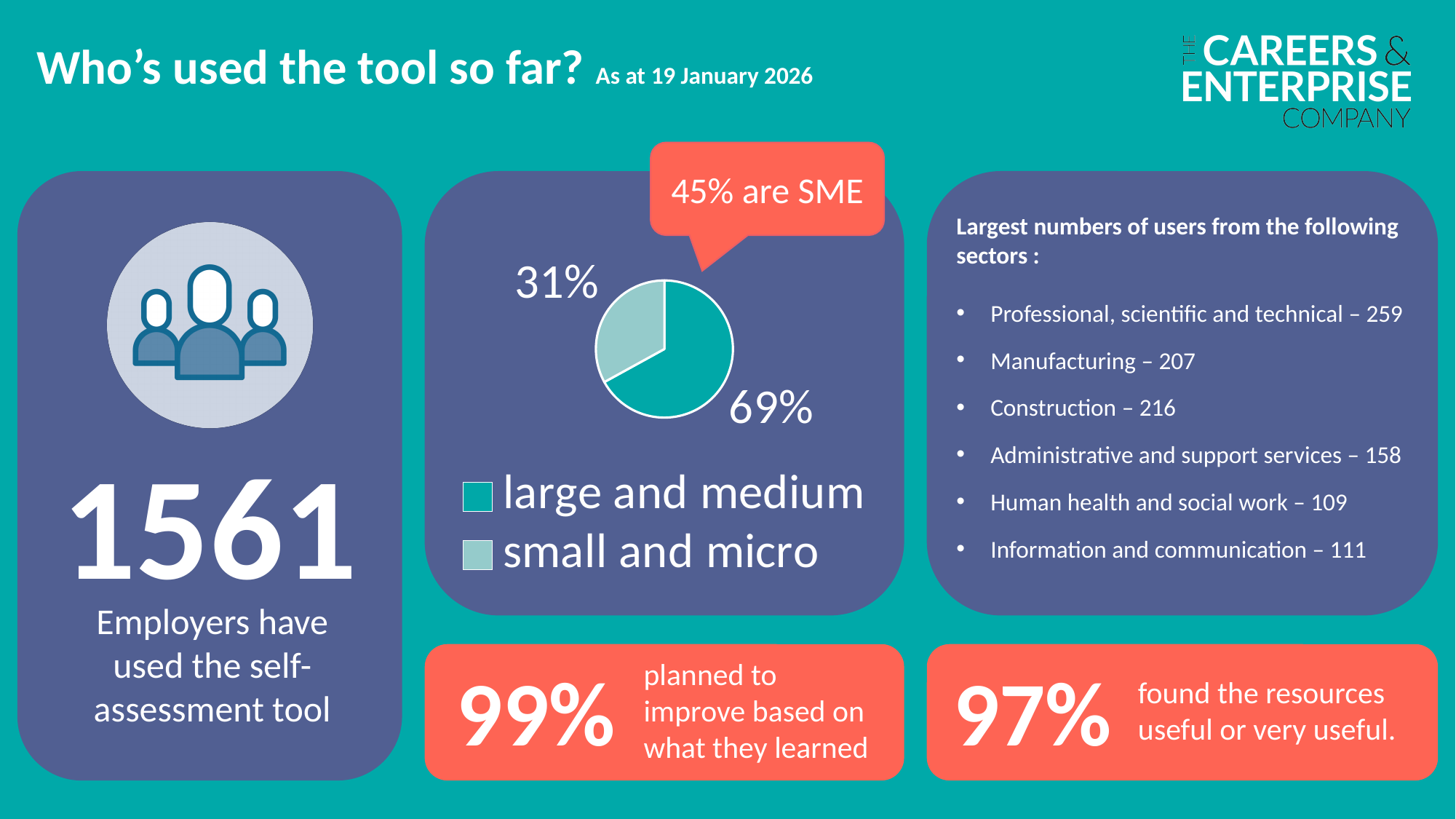
What kind of chart is shown in the middle panel of the slide? pie chart In the pie chart, what percentage is shown for large and medium employers? 69% How many slices does the pie chart have? 2 By how many percentage points does the large and medium slice exceed the small and micro slice in the pie chart? 38 percentage points What are the two legend entries shown below the pie chart? large and medium; small and micro Is the value for large and medium in the pie chart greater or less than 50%? greater How many entries does the pie chart's legend list? 2 In the pie chart, which is larger: the share for large and medium or the share for small and micro? large and medium Which slice of the pie chart is the smallest? small and micro What share of the pie chart does the small and micro slice represent? 31% In the pie chart, what percentage is shown for small and micro employers? 31% Which slice of the pie chart is the largest? large and medium